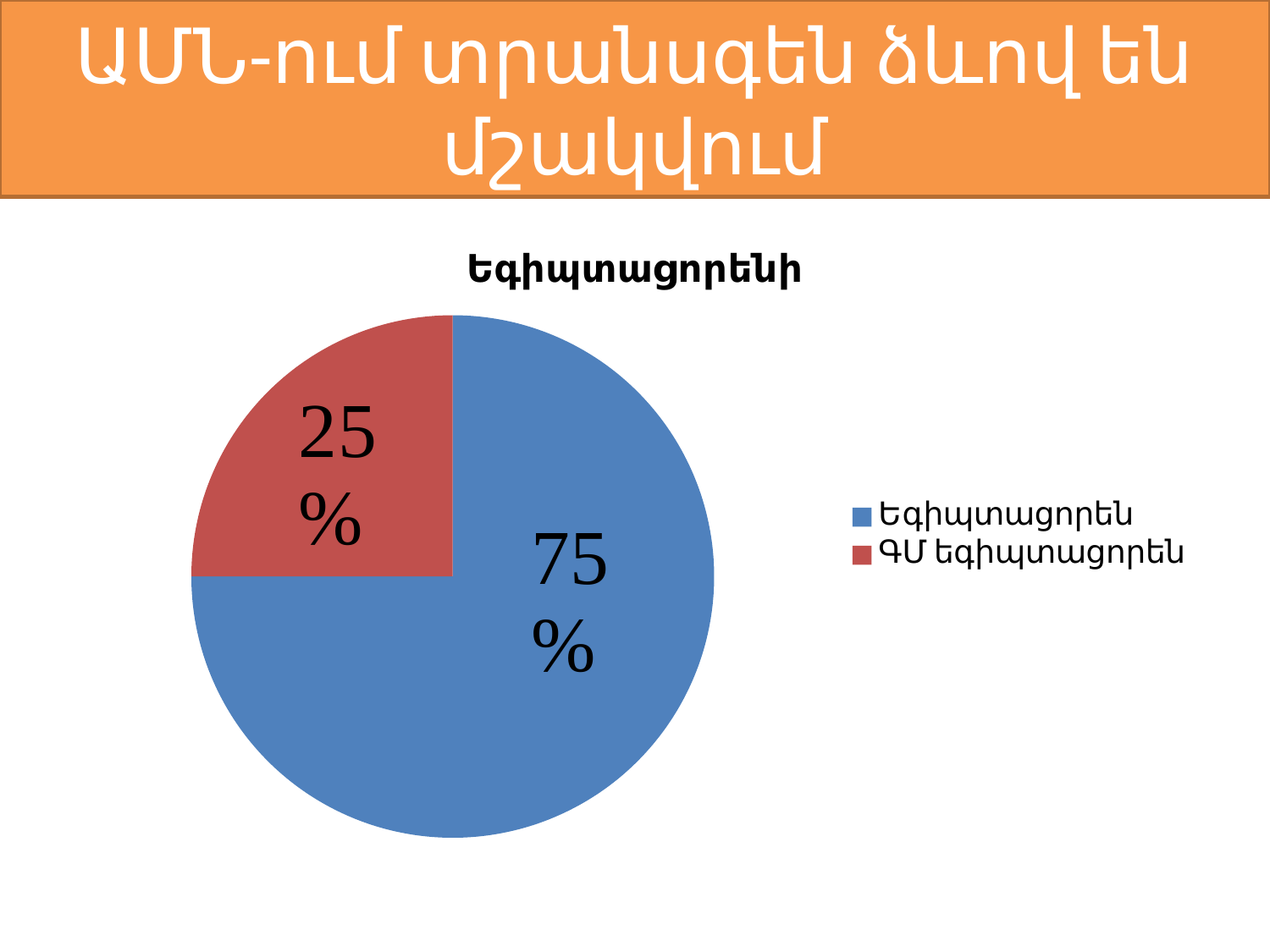
Which slice is the largest in the pie chart? Եգիպտացորեն How many slices does the pie chart have? 2 Which slice is the smallest in the pie chart? ԳՄ եգիպտացորեն What percentage does the Եգիպտացորեն slice show? 75% What is the difference in percentage points between the Եգիպտացորեն slice and the ԳՄ եգիպտացորեն slice? 50 What kind of chart is shown on the slide? pie chart How many entries does the legend list? 2 What percentage does the ԳՄ եգիպտացորեն slice show? 25% What share of the pie does the ԳՄ եգիպտացորեն slice represent? 25% Which is larger, the Եգիպտացորեն slice or the ԳՄ եգիպտացորեն slice? Եգիպտացորեն What is the title of the chart? Եգիպտացորենի What colour is the ԳՄ եգիպտացորեն slice? red